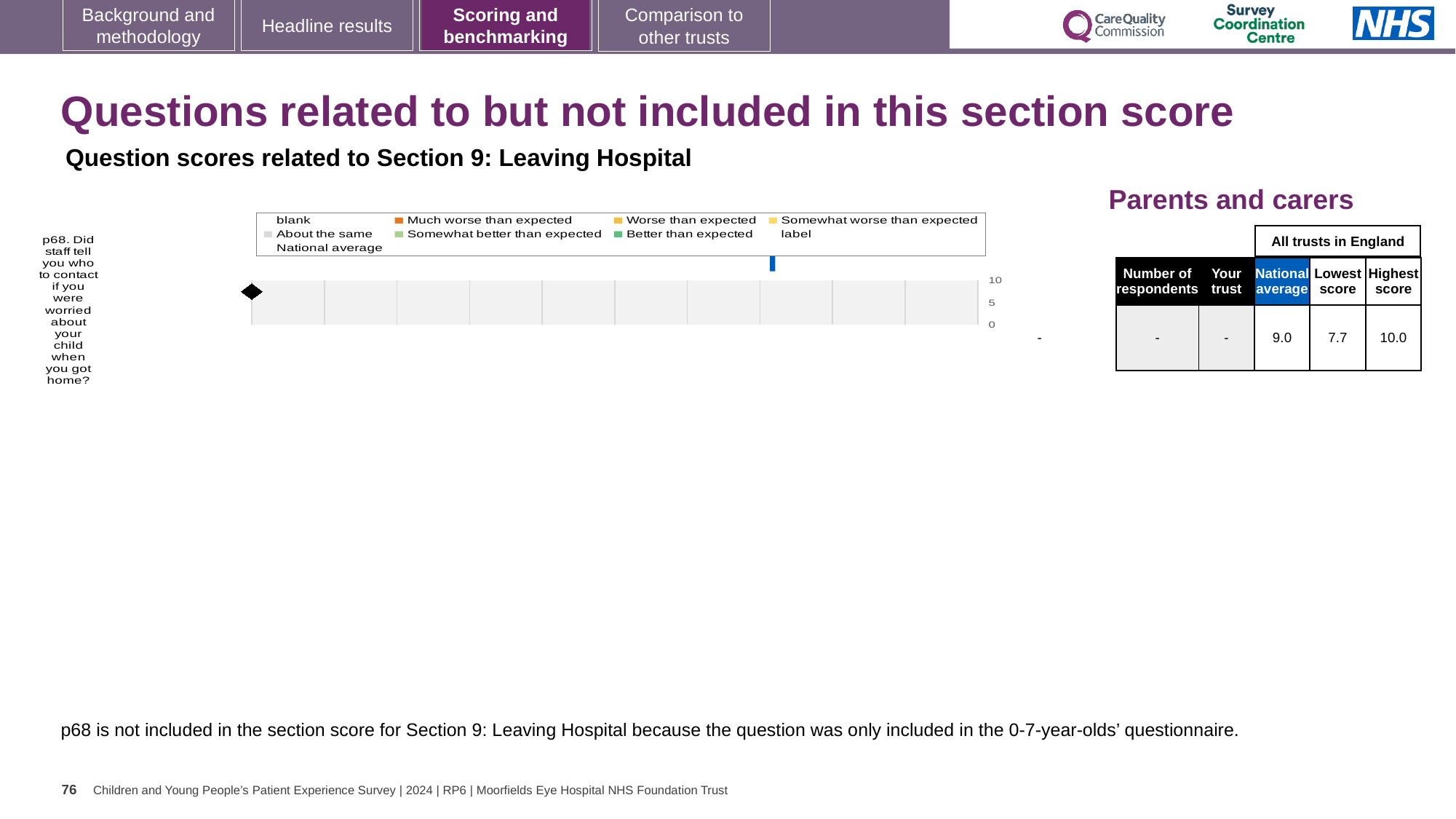
Which legend entry is shown with an orange marker? Much worse than expected In the Parents and carers table, which is larger for p68: the National average or the Lowest score? National average In the Parents and carers table, what is the National average score for p68? 9.0 In the Parents and carers table, what is the Highest score for p68? 10.0 How many entries does the chart legend list? 9 What is the highest value shown on the chart's axis? 10 In the Parents and carers table, is the National average for p68 greater or less than 5? greater What kind of chart is shown on the slide? bar chart Which question is plotted on the chart? p68. Did staff tell you who to contact if you were worried about your child when you got home? In the Parents and carers table, what is the difference between the Highest score and the Lowest score for p68? 2.3 In the Parents and carers table, what is the Lowest score for p68? 7.7 How many questions (categories) are plotted on the chart? 1